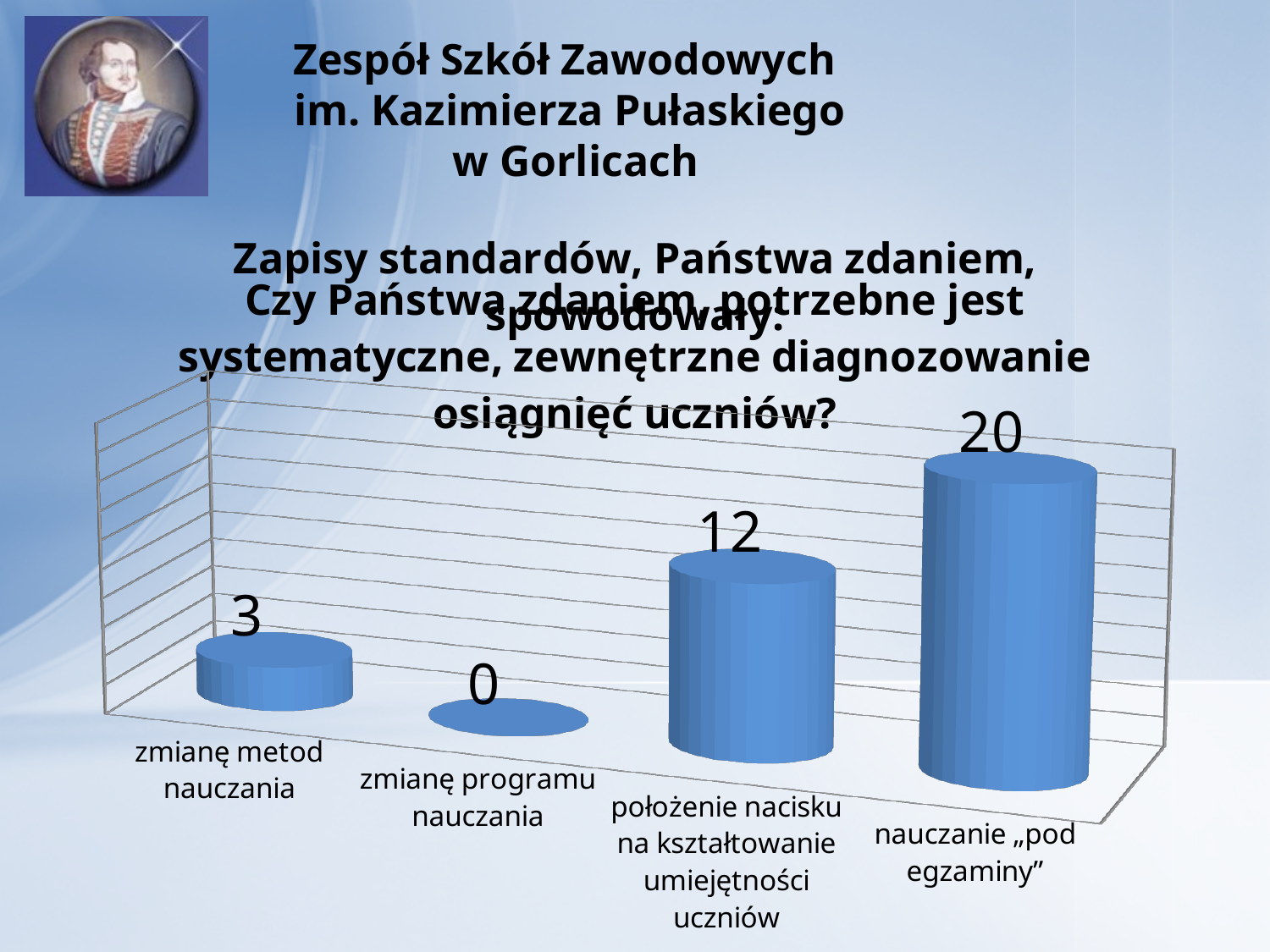
What colour are the bars in the chart? blue What value is shown for "zmianę metod nauczania"? 3 What kind of chart is shown on the slide? bar chart What value is shown for "nauczanie „pod egzaminy”"? 20 What value is shown for "położenie nacisku na kształtowanie umiejętności uczniów"? 12 Which category has the lowest value? zmianę programu nauczania What is the difference between the values for "położenie nacisku na kształtowanie umiejętności uczniów" and "zmianę metod nauczania"? 9 What is the difference between the values for "nauczanie „pod egzaminy”" and "położenie nacisku na kształtowanie umiejętności uczniów"? 8 Which is larger: the value for "zmianę metod nauczania" or the value for "zmianę programu nauczania"? zmianę metod nauczania How many categories are shown in the chart? 4 What value is shown for "zmianę programu nauczania"? 0 Which category has the highest value? nauczanie „pod egzaminy”